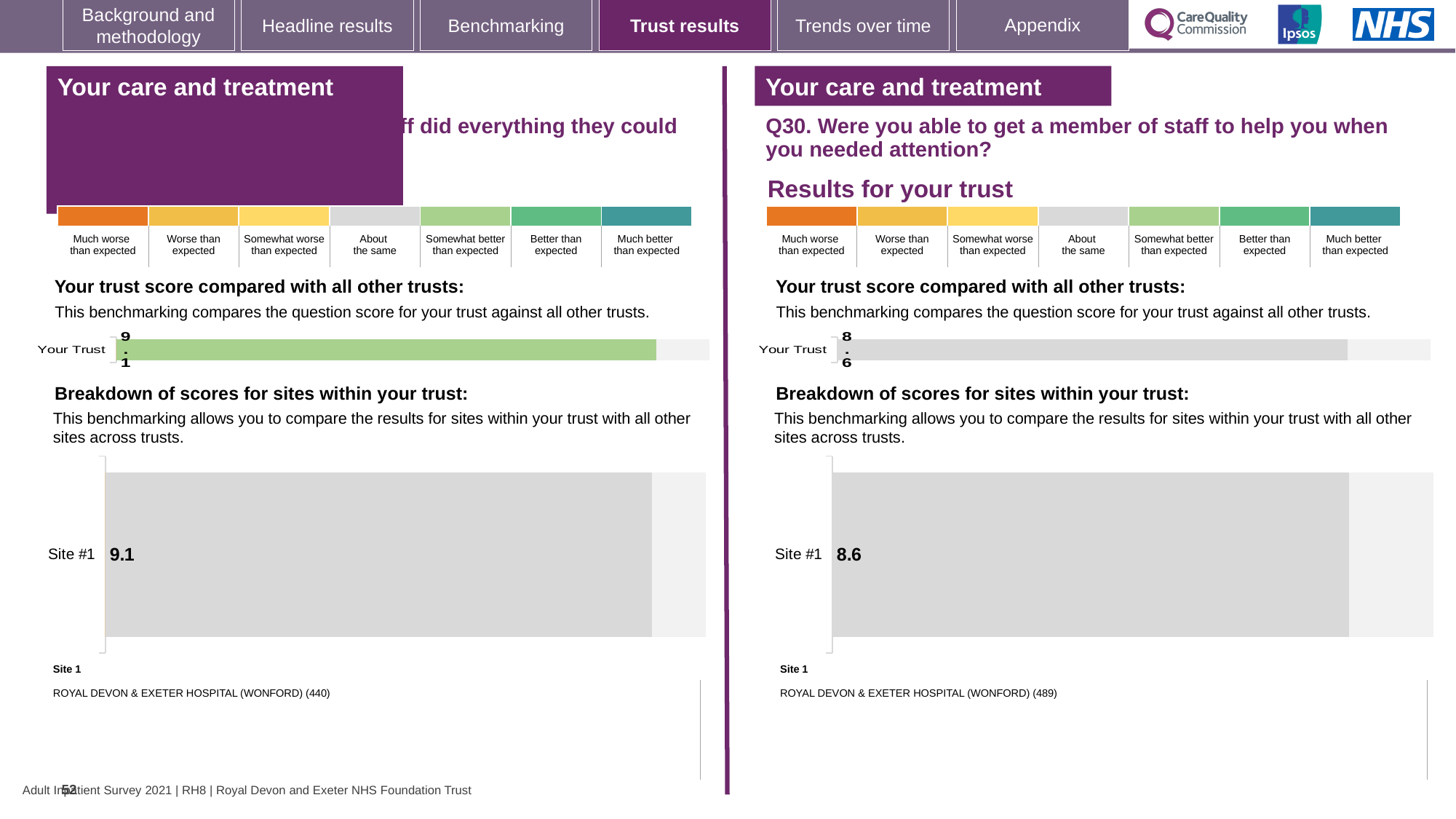
On the left-hand panel, which benchmark category does the light green colour of the Your Trust bar correspond to in the colour key? Somewhat better than expected On the left-hand panel, what is the score shown for Your Trust in the 'Your trust score compared with all other trusts' chart? 9.1 Which is larger: the Your Trust score on the left-hand panel or the Your Trust score on the right-hand panel (Q30)? Left-hand panel (9.1) Which site is listed as Site 1 on the right-hand panel (Q30), and how many respondents are shown in brackets? ROYAL DEVON & EXETER HOSPITAL (WONFORD) (489) Is the Site #1 score on the left-hand panel the same as the Your Trust score on the left-hand panel? Yes, both are 9.1 What type of chart is used to show the Your Trust score on the left-hand panel? Bar chart On the right-hand panel (Q30), what is the score shown for Your Trust in the 'Your trust score compared with all other trusts' chart? 8.6 What is the difference between the Your Trust score on the left-hand panel (9.1) and the Your Trust score on the right-hand panel (8.6)? 0.5 On the left-hand panel, what score is shown for Site #1 in the 'Breakdown of scores for sites within your trust' chart? 9.1 How many sites are shown in the 'Breakdown of scores for sites within your trust' chart on the right-hand panel (Q30)? 1 On the right-hand panel (Q30), which benchmark category does the grey colour of the Your Trust bar correspond to in the colour key? About the same On the right-hand panel (Q30), what score is shown for Site #1 in the 'Breakdown of scores for sites within your trust' chart? 8.6